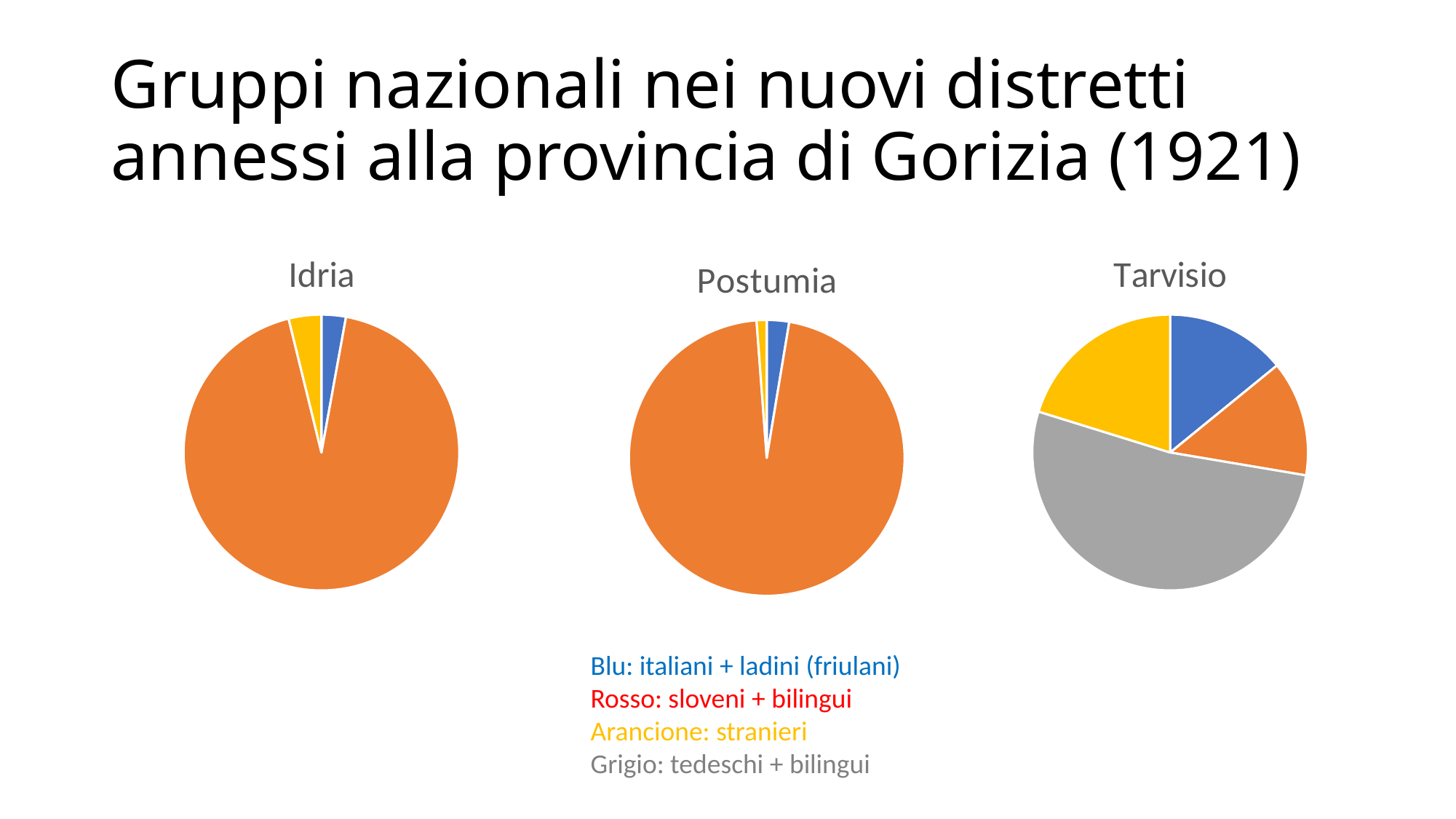
According to the legend text, what group does the blue colour represent? italiani + ladini (friulani) How many slices does the Tarvisio pie chart have? 4 How many slices does the Idria pie chart have? 3 In the Tarvisio pie chart, which colour slice is the largest? Grey How many slices does the Postumia pie chart have? 3 In the Tarvisio pie chart, which is larger, the blue slice or the yellow slice? Yellow In the Postumia pie chart, which colour slice is the largest? Orange In the Idria pie chart, which colour slice is the largest? Orange Which of the three pie charts contains a grey slice? Tarvisio What kind of charts are shown on the slide? Pie charts